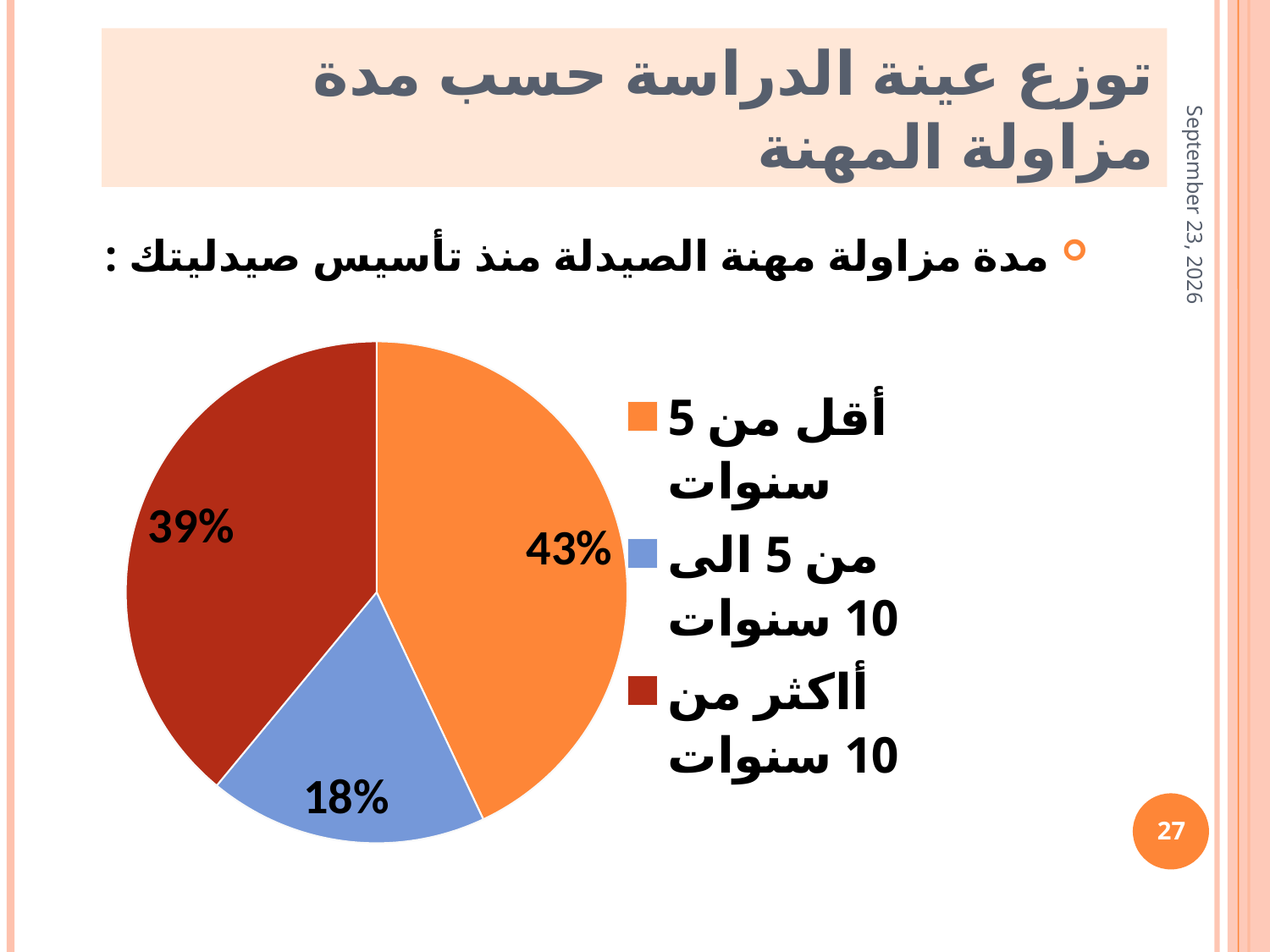
What colour is the slice for "من 5 الى 10 سنوات"? blue What share of the pie does the category "أاكثر من 10 سنوات" (more than 10 years) have? 39% Which category has the largest slice of the pie? أقل من 5 سنوات What share of the pie does the category "أقل من 5 سنوات" (less than 5 years) have? 43% What kind of chart is shown on the slide? pie chart What is the difference in percentage points between the "أقل من 5 سنوات" slice and the "أاكثر من 10 سنوات" slice? 4% How many categories does the pie chart have? 3 Which is larger: the slice for "من 5 الى 10 سنوات" or the slice for "أاكثر من 10 سنوات"? أاكثر من 10 سنوات What is the difference in percentage points between the "أاكثر من 10 سنوات" slice and the "من 5 الى 10 سنوات" slice? 21% What colour is the slice for "أقل من 5 سنوات"? orange Which category has the smallest slice of the pie? من 5 الى 10 سنوات What share of the pie does the category "من 5 الى 10 سنوات" (5 to 10 years) have? 18%